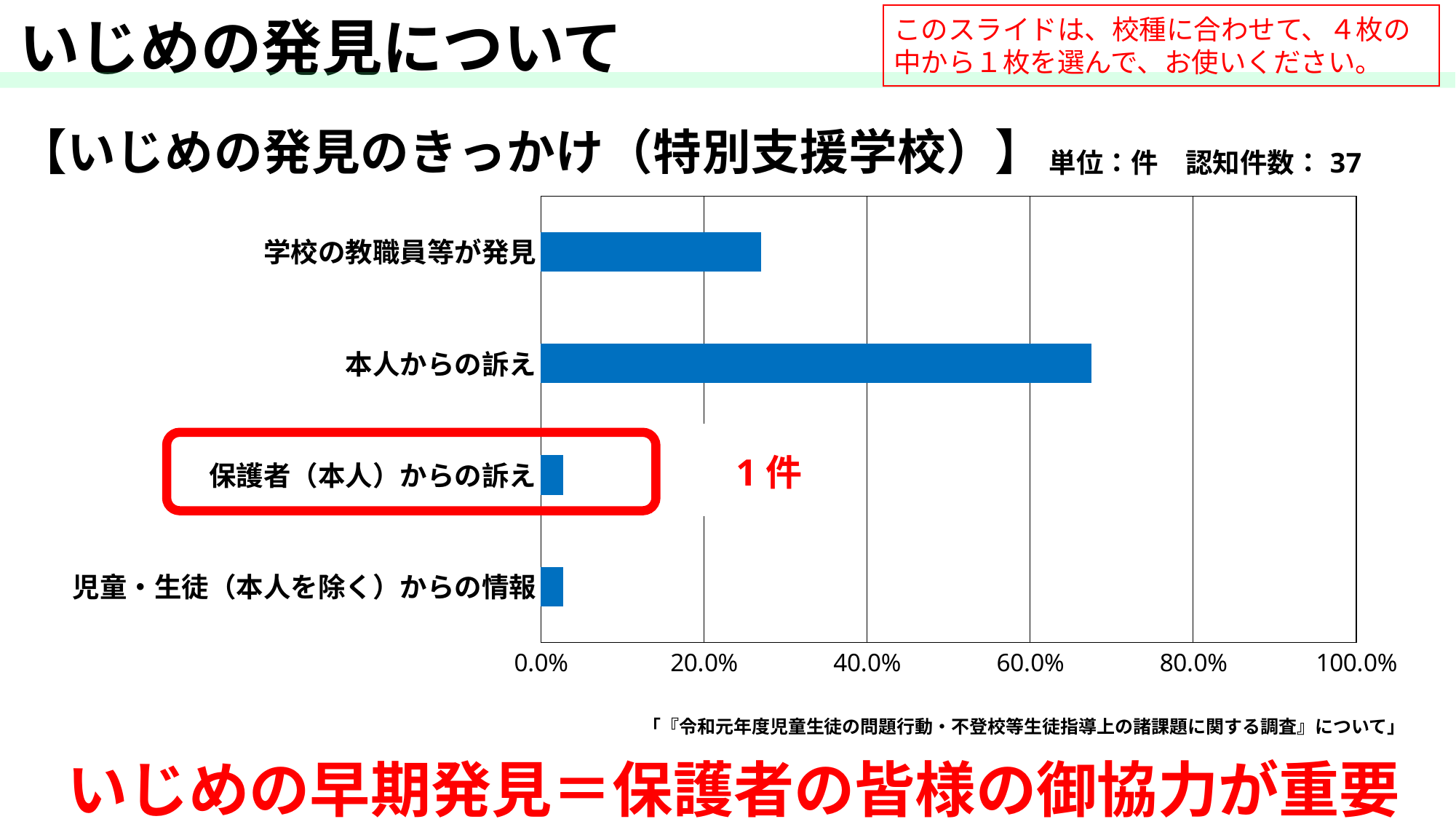
Is the value for 児童・生徒（本人を除く）からの情報 greater or less than 20.0%? less Is the value for 学校の教職員等が発見 greater or less than 40.0%? less Is the value for 学校の教職員等が発見 greater or less than 20.0%? greater How many categories are plotted in the chart? 4 How many cases does the red annotation next to the 保護者（本人）からの訴え bar show? 1件 Which is larger, the value for 本人からの訴え or the value for 学校の教職員等が発見? 本人からの訴え What is the 認知件数 (number of recognized cases) stated above the chart? 37 What kind of chart is shown on the slide? bar chart Which category has the highest value in the chart? 本人からの訴え What is the title of the chart? いじめの発見のきっかけ（特別支援学校）